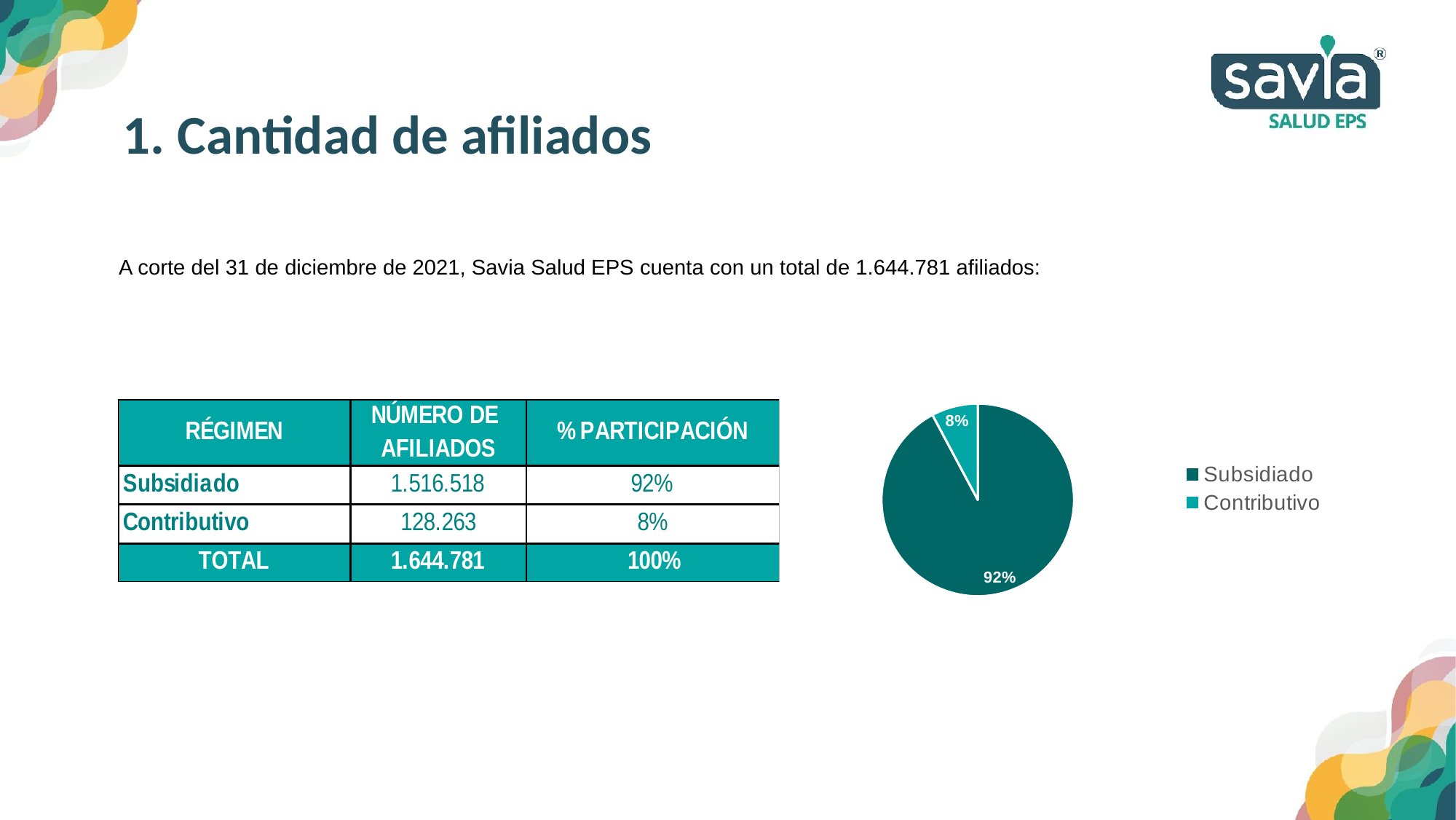
Which is larger in the pie chart, Subsidiado or Contributivo? Subsidiado Which slice of the pie chart is the smallest? Contributivo How many entries does the legend of the pie chart list? 2 How many slices does the pie chart have? 2 Is the share for Subsidiado greater or less than 50%? greater What share of the pie does Contributivo represent? 8% What kind of chart is shown on the slide? pie chart Which legend entry is shown in the lighter teal colour? Contributivo What is the difference in percentage points between the Subsidiado and Contributivo slices? 84 What share of the pie does Subsidiado represent? 92% Which slice of the pie chart is the largest? Subsidiado